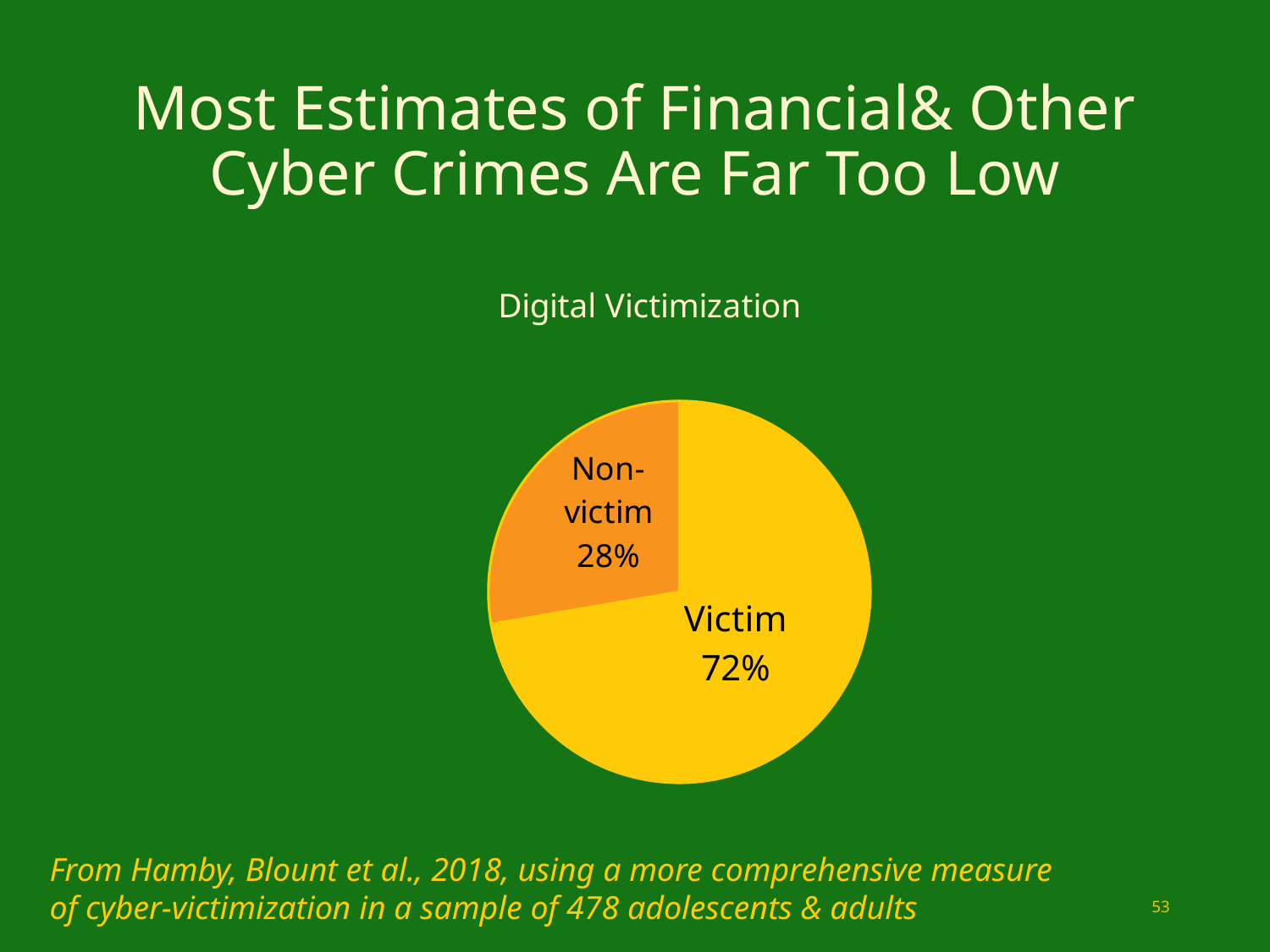
How many slices does the pie chart have? 2 What percentage of the pie is labelled Victim? 72% What kind of chart is shown on the slide? Pie chart Which is larger, the Victim slice or the Non-victim slice? Victim What is the title of the chart? Digital Victimization Which slice of the pie is the largest? Victim Which slice of the pie is the smallest? Non-victim What is the difference in percentage points between the Victim and Non-victim slices? 44 What colour is the Non-victim slice? Orange What percentage of the pie is labelled Non-victim? 28% What share of the pie does the Victim slice represent? 72%